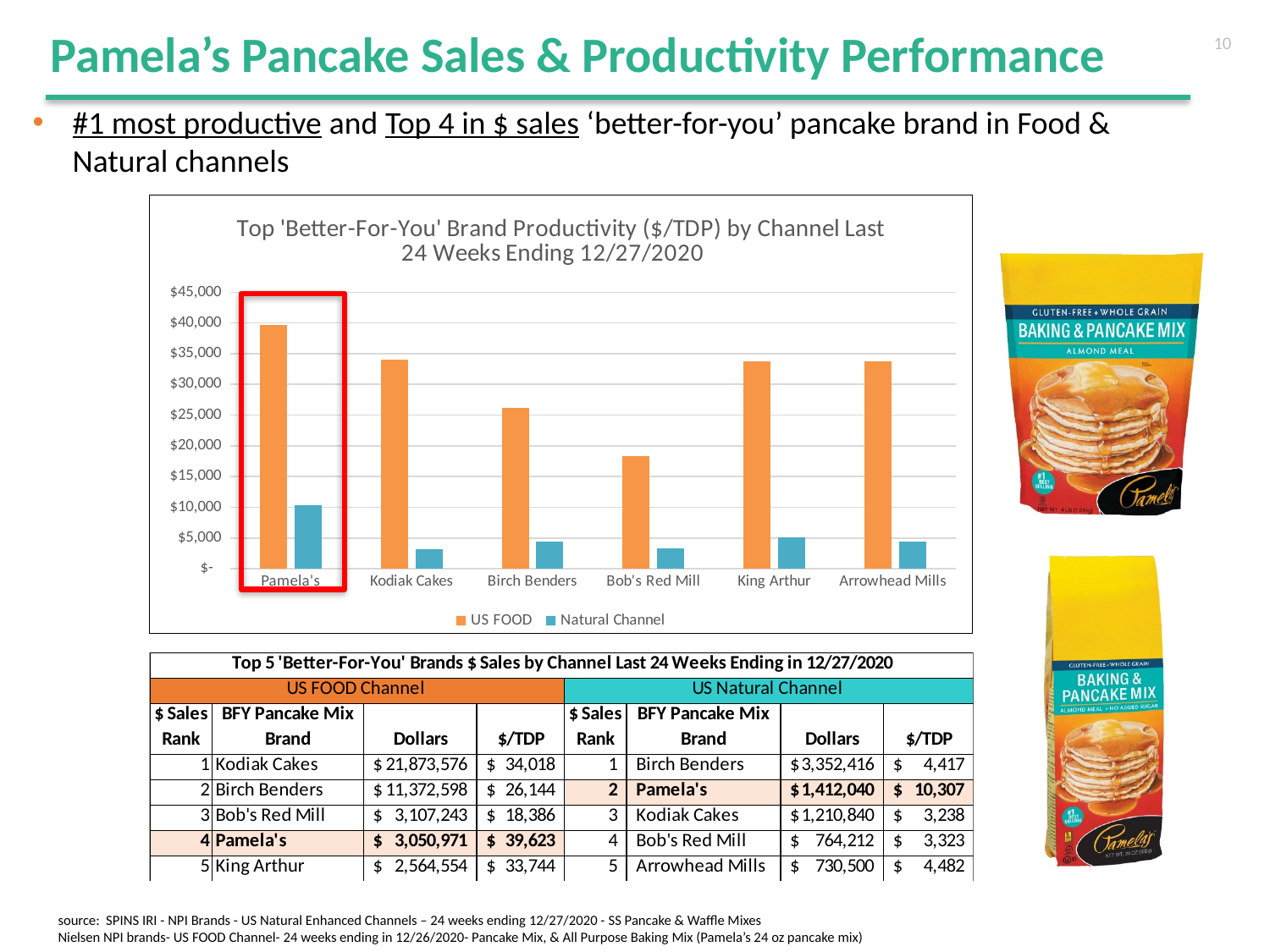
What kind of chart is shown on the slide? Bar chart Is the US FOOD value for Bob's Red Mill greater or less than $20,000? less In the chart, which has the larger US FOOD value, Kodiak Cakes or Birch Benders? Kodiak Cakes How many brands are shown on the x axis of the chart? 6 Is the Natural Channel value for Kodiak Cakes greater or less than $5,000? less Which brand has the highest Natural Channel productivity in the chart? Pamela's Which brand has the lowest US FOOD productivity in the chart? Bob's Red Mill Which series is shown in orange in the chart's legend? US FOOD In the chart, which has the larger Natural Channel value, Pamela's or Kodiak Cakes? Pamela's Which brand has the highest US FOOD productivity in the chart? Pamela's Is the US FOOD value for Pamela's greater or less than $35,000? greater How many series does the chart's legend list? 2